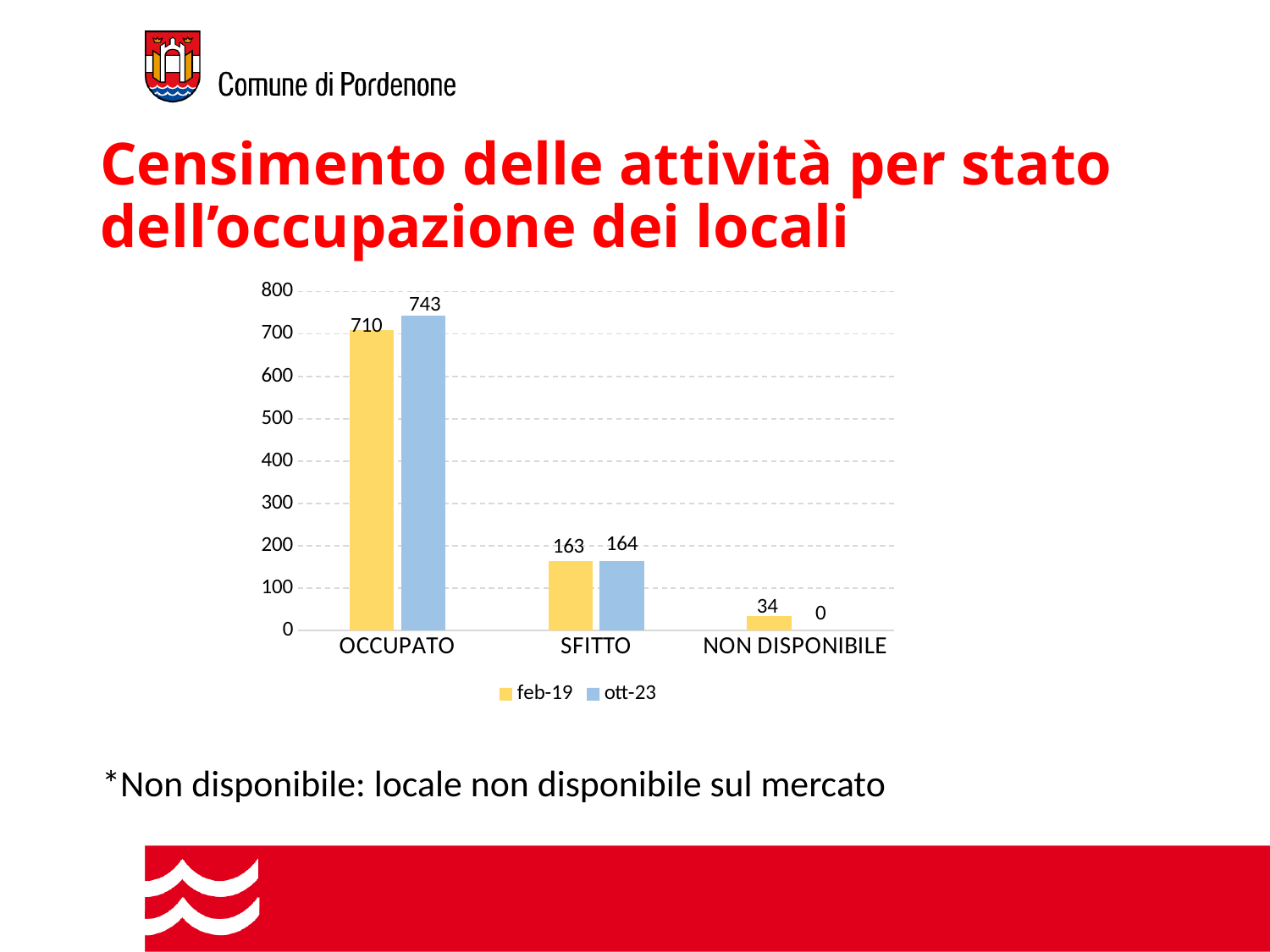
What is the value for OCCUPATO in the feb-19 series? 710 What are the two series named in the legend? feb-19 and ott-23 Which category has the lowest value in the feb-19 series? NON DISPONIBILE What is the difference between the ott-23 and feb-19 values for OCCUPATO? 33 How many series does the legend list? 2 Which category has the highest value in the ott-23 series? OCCUPATO Which is larger for NON DISPONIBILE: the feb-19 value or the ott-23 value? feb-19 What is the value for NON DISPONIBILE in the ott-23 series? 0 What is the value for SFITTO in the feb-19 series? 163 What kind of chart is shown on the slide? bar chart What is the value for OCCUPATO in the ott-23 series? 743 How many categories are shown on the x axis? 3